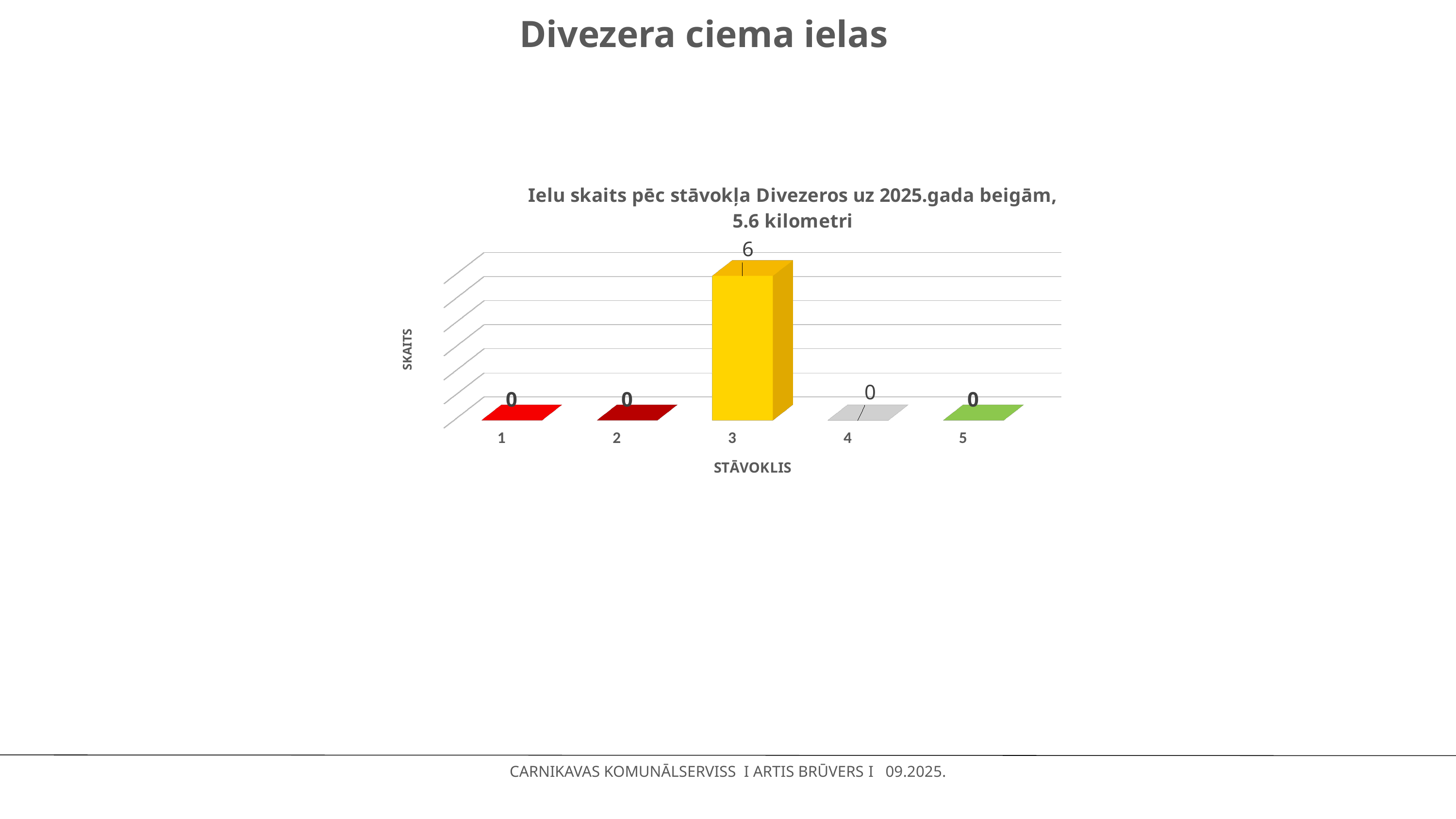
Which is larger, the value for category 3 or the value for category 2? category 3 What is the value for category 3? 6 What is the difference between the values for category 3 and category 4? 6 What is the total of all the values shown in the chart? 6 What is the value for category 1? 0 Which category has the highest value? 3 What is the title of the chart? Ielu skaits pēc stāvokļa Divezeros uz 2025.gada beigām, 5.6 kilometri What is the label of the x axis? STĀVOKLIS What is the value for category 5? 0 What kind of chart is shown on the slide? bar chart How many categories are shown on the x axis? 5